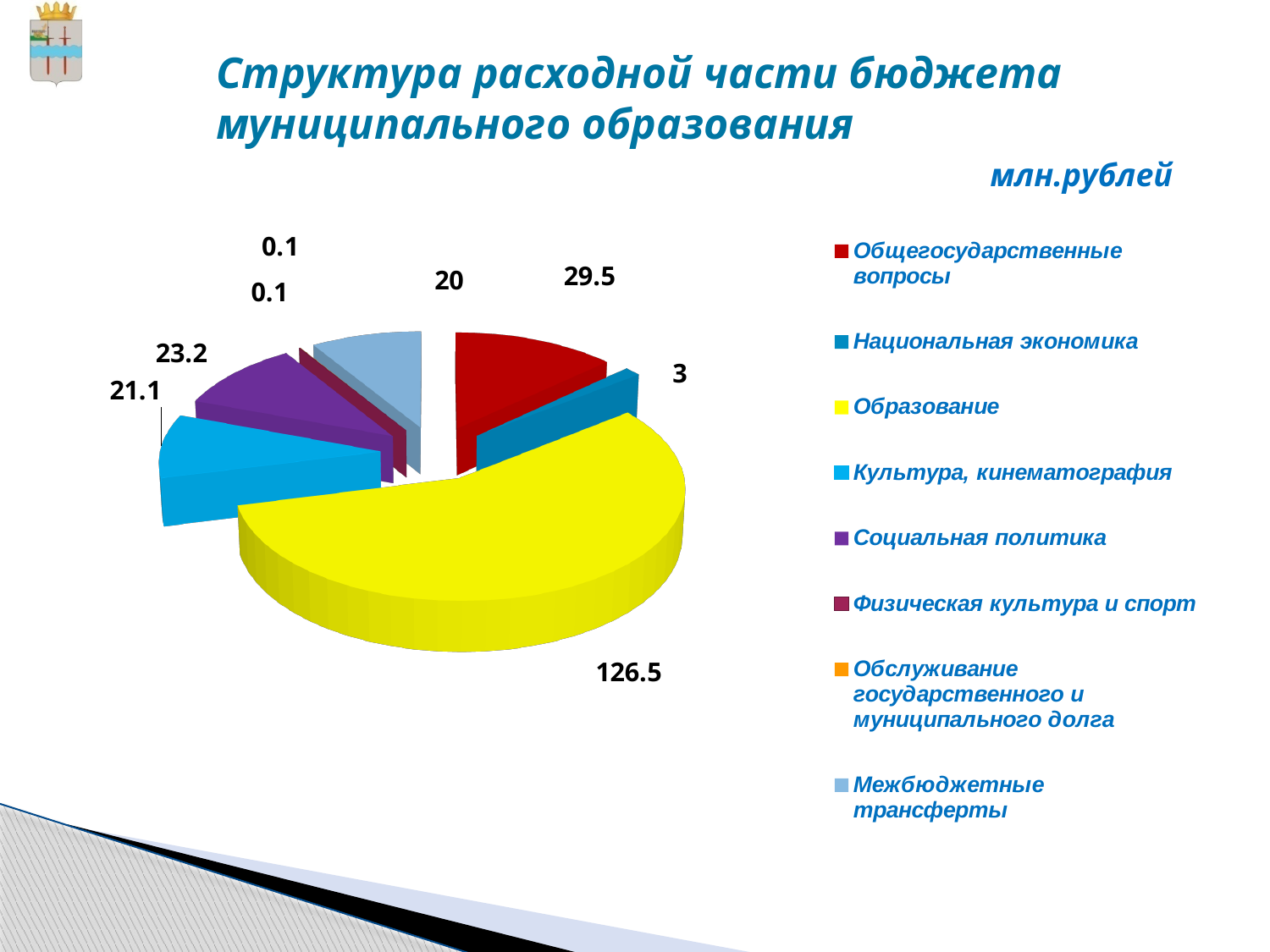
What is the value for Общегосударственные вопросы? 29.5 What unit is stated for the values on the slide? млн.рублей What is the value for Национальная экономика? 3 How many categories does the legend list? 8 What is the value for Межбюджетные трансферты? 20 What is the value for Образование? 126.5 What is the value for Культура, кинематография? 21.1 Which category has the largest slice of the pie? Образование What is the value for Социальная политика? 23.2 Which is larger, the value for Социальная политика or the value for Культура, кинематография? Социальная политика What kind of chart is shown on the slide? pie chart What is the difference between the values for Образование and Общегосударственные вопросы? 97